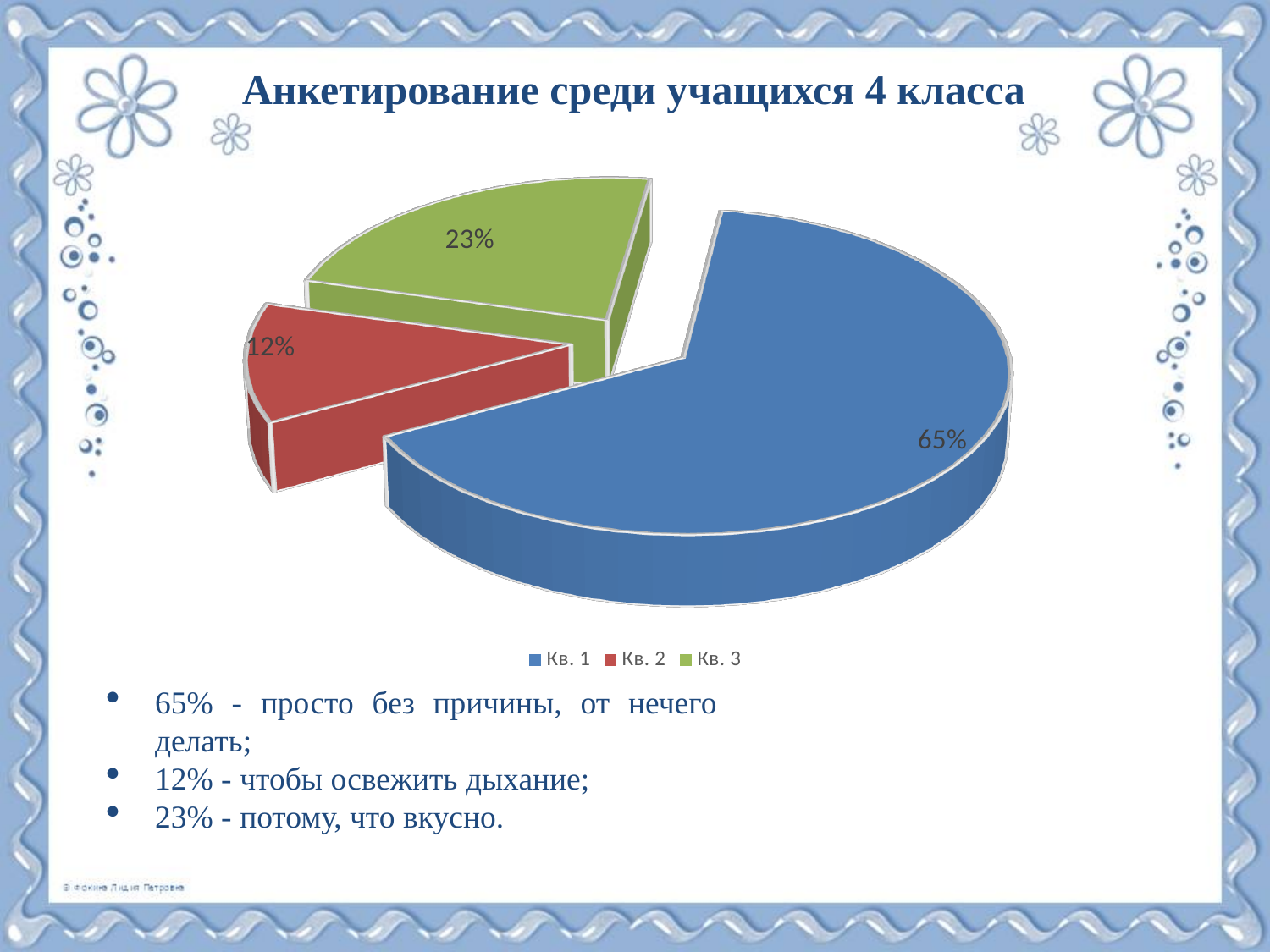
Which slice is larger, Кв. 2 or Кв. 3? Кв. 3 What share of the pie does the slice for Кв. 3 represent? 23% What share of the pie does the slice for Кв. 2 represent? 12% Which category has the largest slice of the pie? Кв. 1 What share of the pie does the slice for Кв. 1 represent? 65% What kind of chart is shown on the slide? pie chart How many entries does the legend list? 3 What is the difference in percentage points between the slices for Кв. 3 and Кв. 2? 11 What is the difference in percentage points between the slices for Кв. 1 and Кв. 3? 42 What colour is the slice for Кв. 3? green How many slices does the pie chart have? 3 Which category has the smallest slice of the pie? Кв. 2